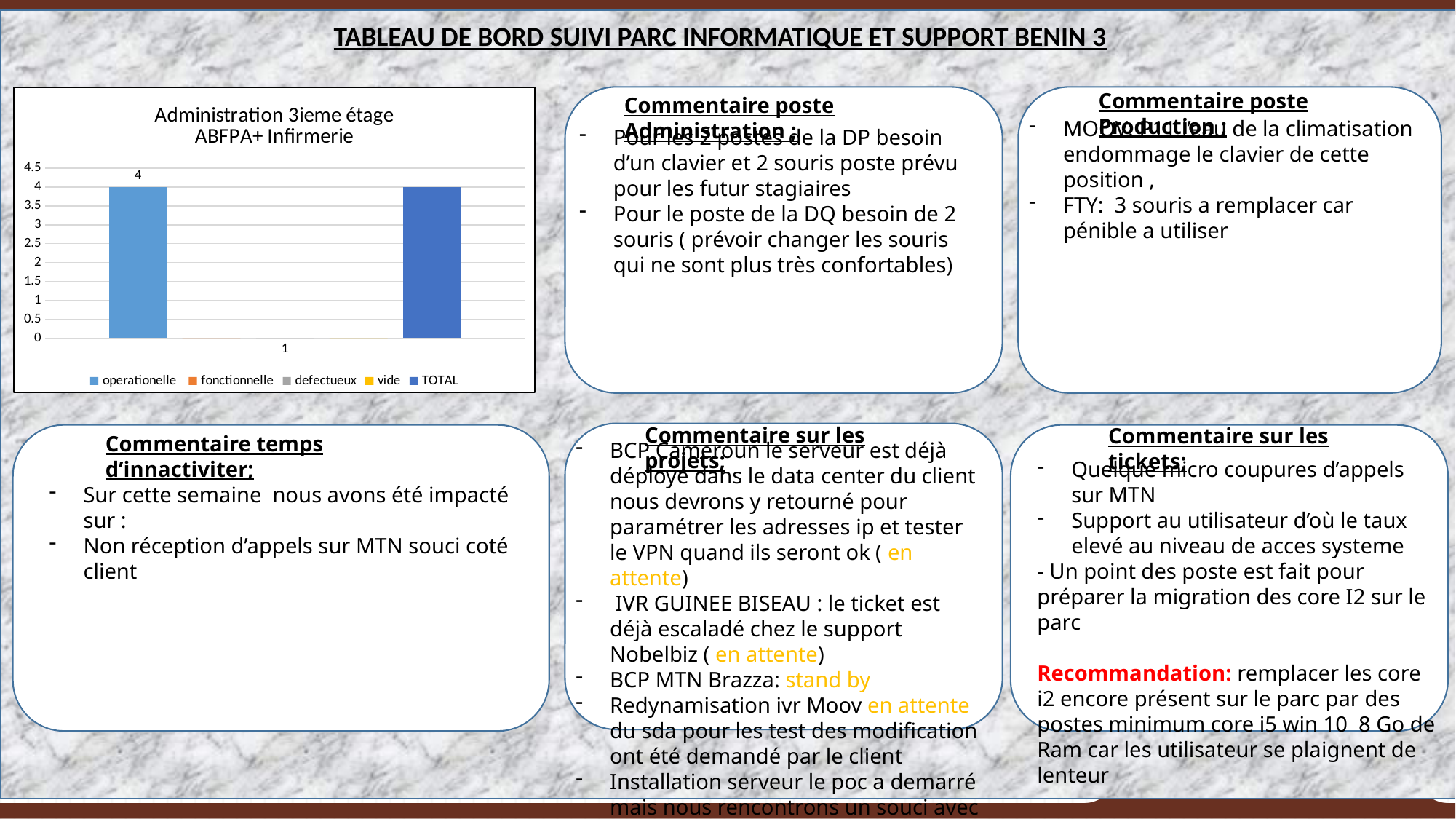
How many categories are shown on the x axis of the chart? 1 What is the highest value shown on the chart's y axis? 4.5 Which series is listed first in the chart legend? operationelle Is the value for TOTAL greater or less than 2? greater What is the value of the operationelle bar? 4 What is the value of the TOTAL bar? 4 How many series does the chart legend list? 5 What is the label of the single category on the x axis? 1 Is the value for operationelle greater or less than 3? greater What is the title of the chart? Administration 3ieme étage ABFPA+ Infirmerie What kind of chart is shown on the slide? bar chart